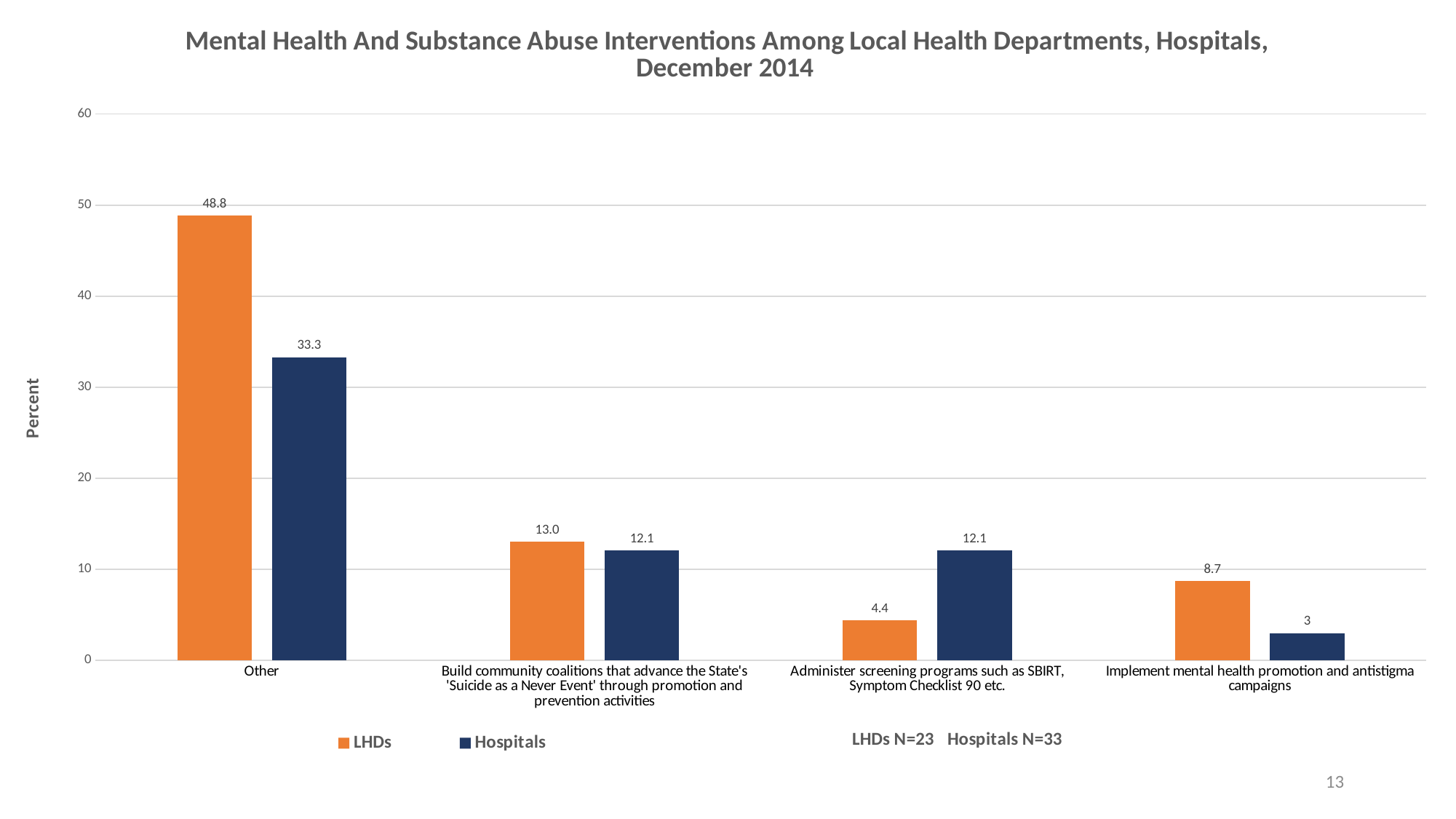
What is the difference between the LHDs and Hospitals values for the 'Other' category? 15.5 Is the Hospitals value for 'Other' greater or less than 30? greater What kind of chart is shown on the slide? Bar chart How many series does the legend list? 2 What is the label of the y axis? Percent What is the Hospitals value for 'Administer screening programs such as SBIRT, Symptom Checklist 90 etc.'? 12.1 Which category has the highest LHDs value? Other For 'Administer screening programs such as SBIRT, Symptom Checklist 90 etc.', which is larger, the LHDs value or the Hospitals value? Hospitals How many categories are shown on the x axis? 4 Which category has the lowest Hospitals value? Implement mental health promotion and antistigma campaigns What is the Hospitals value for 'Implement mental health promotion and antistigma campaigns'? 3 What is the LHDs value for the 'Other' category? 48.8